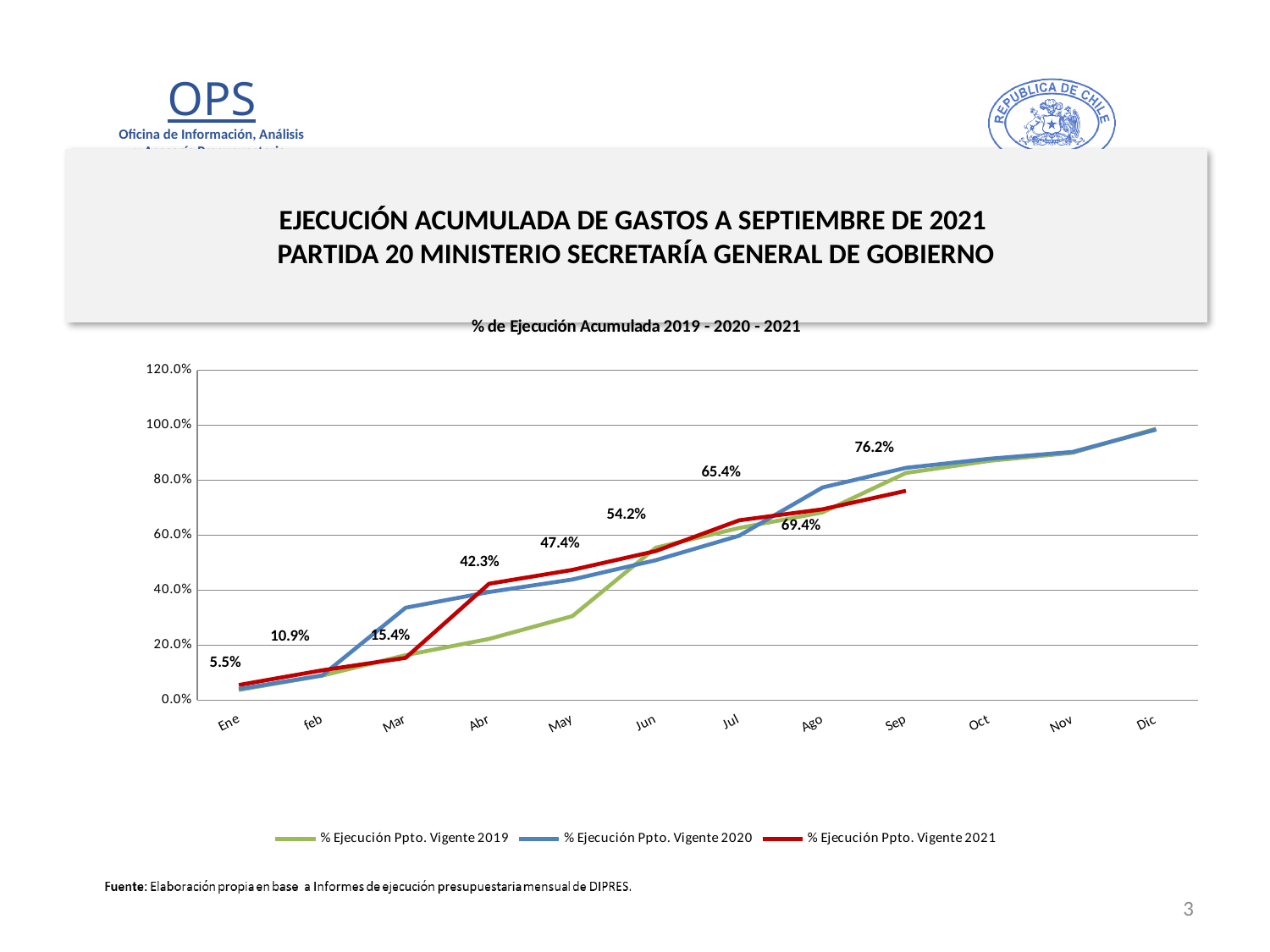
What is the value for Ene in the % Ejecución Ppto. Vigente 2021 series? 5.5% What is the difference between the Sep and Ago values of the % Ejecución Ppto. Vigente 2021 series? 6.8% What is the value for Jul in the % Ejecución Ppto. Vigente 2021 series? 65.4% How many months are shown on the x axis? 12 Is the value for Dic in the % Ejecución Ppto. Vigente 2020 series greater or less than 80.0%? greater How many series does the legend list? 3 What kind of chart is shown on the slide? Line chart What is the value for Sep in the % Ejecución Ppto. Vigente 2021 series? 76.2% Which month has the highest value in the % Ejecución Ppto. Vigente 2021 series? Sep What is the value for Abr in the % Ejecución Ppto. Vigente 2021 series? 42.3% In Mar, which series has the larger value: % Ejecución Ppto. Vigente 2020 or % Ejecución Ppto. Vigente 2019? % Ejecución Ppto. Vigente 2020 What is the difference between the Abr and Mar values of the % Ejecución Ppto. Vigente 2021 series? 26.9%